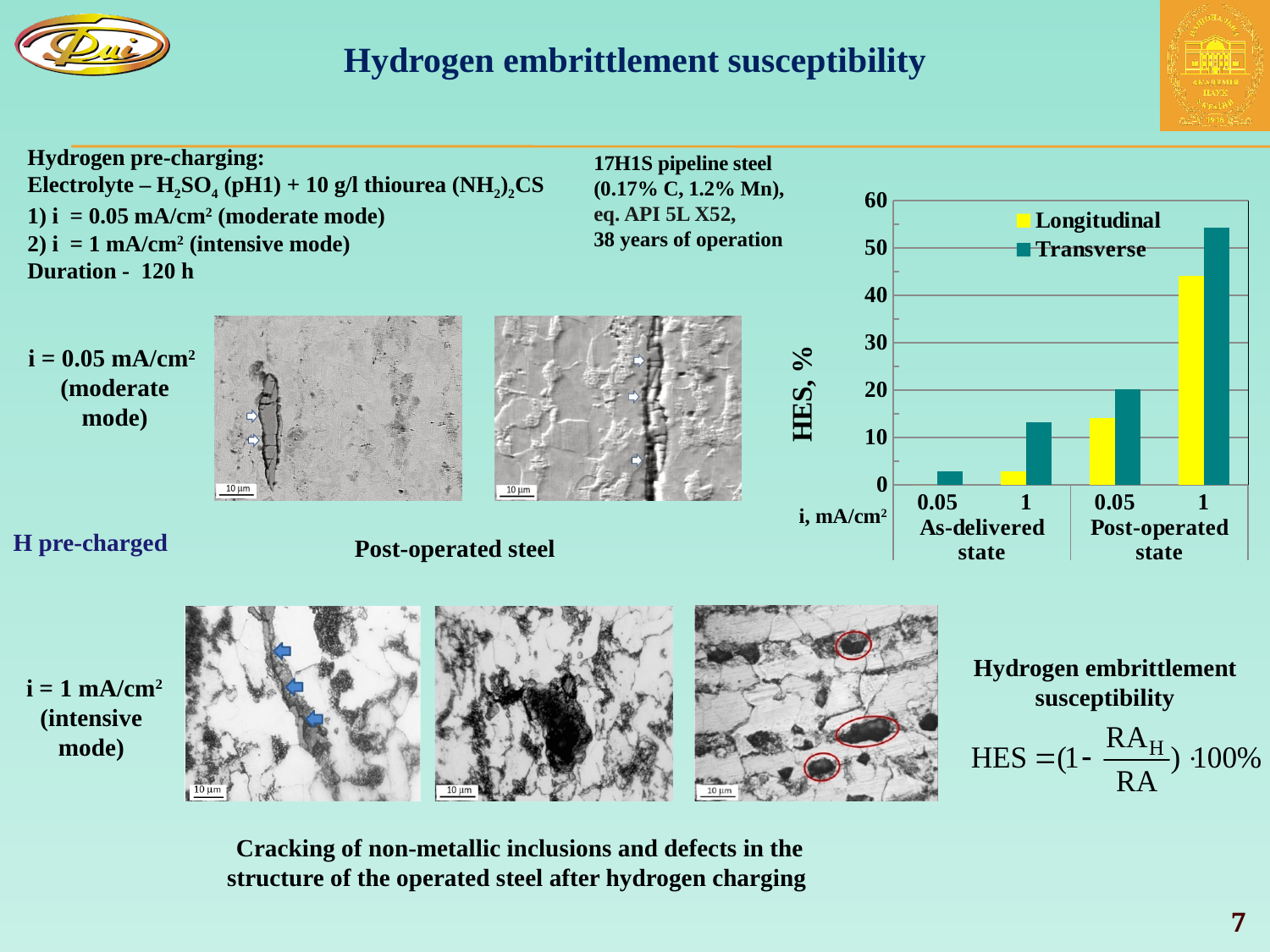
What kind of chart is shown on the slide? bar chart Do the Transverse HES values rise or fall moving from left to right along the x axis of the chart? rise What is the label of the vertical axis of the chart? HES, % How many groups of bars (current density conditions) are plotted on the x axis of the chart? 4 How many series does the chart legend list? 2 Which bar in the chart has the highest HES value? Transverse, Post-operated state, 1 mA/cm² For the Post-operated state at 1 mA/cm², which series has the larger HES value, Longitudinal or Transverse? Transverse Is the Transverse HES value for the Post-operated state at 1 mA/cm² greater or less than 50? greater Which state shows higher HES values in the chart, As-delivered or Post-operated? Post-operated state Is the Longitudinal HES value for the Post-operated state at 1 mA/cm² greater or less than 40? greater Which two series are listed in the chart legend? Longitudinal and Transverse Is the Transverse HES value for the As-delivered state at 1 mA/cm² greater or less than 20? less